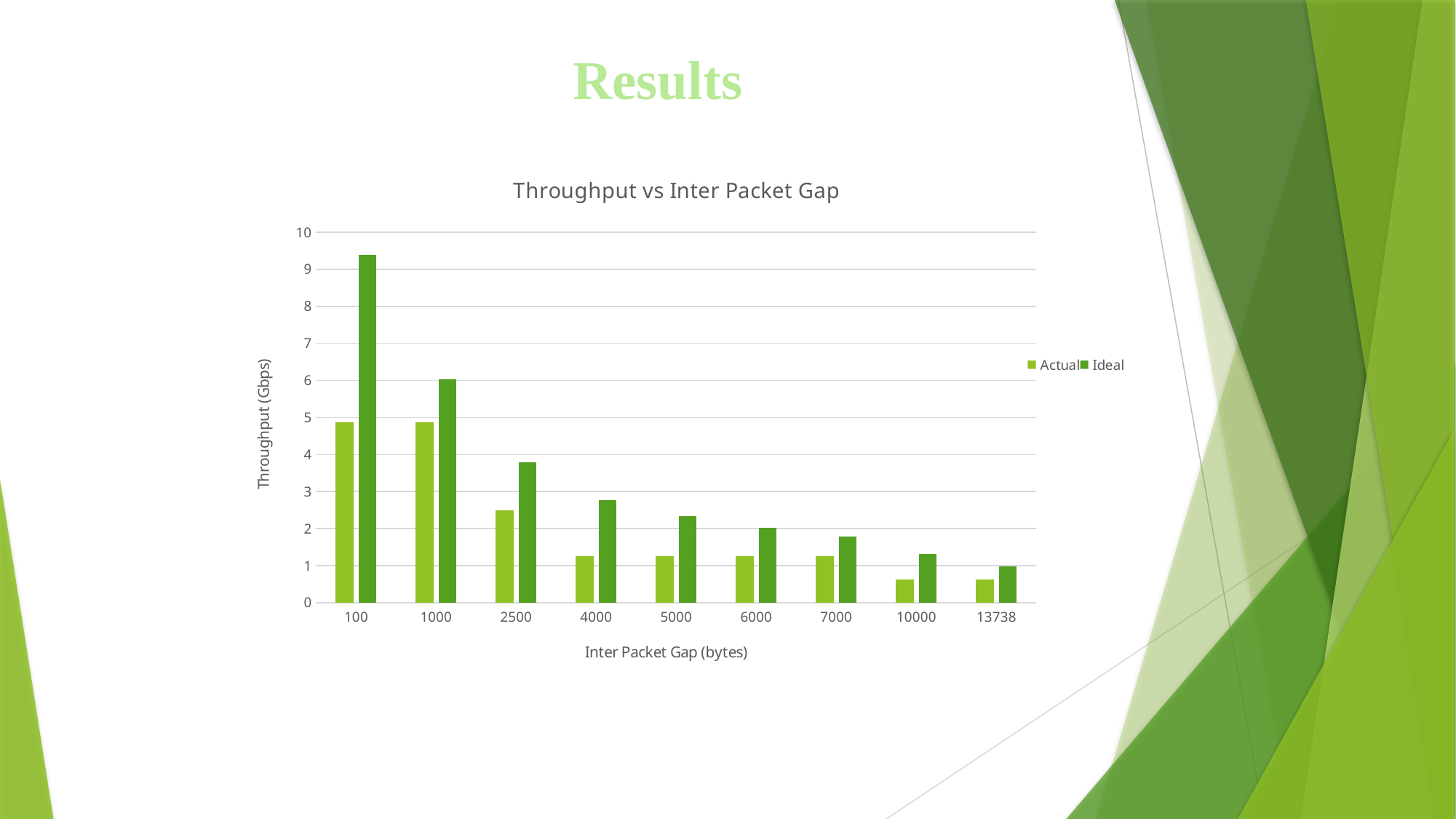
Which inter packet gap has the highest Ideal throughput? 100 Which inter packet gap has the lowest Ideal throughput? 13738 Do the Ideal throughput values rise or fall as the inter packet gap increases along the x axis? fall Is the Actual throughput at an inter packet gap of 13738 greater or less than 1? less What type of chart is shown on the slide? bar chart How many series does the legend list? 2 What is the title of the chart? Throughput vs Inter Packet Gap Is the Actual throughput at an inter packet gap of 2500 greater or less than 2? greater At an inter packet gap of 100, which is larger, the Actual or the Ideal throughput? Ideal Is the Ideal throughput at an inter packet gap of 100 greater or less than 9? greater How many inter packet gap categories are shown on the x axis? 9